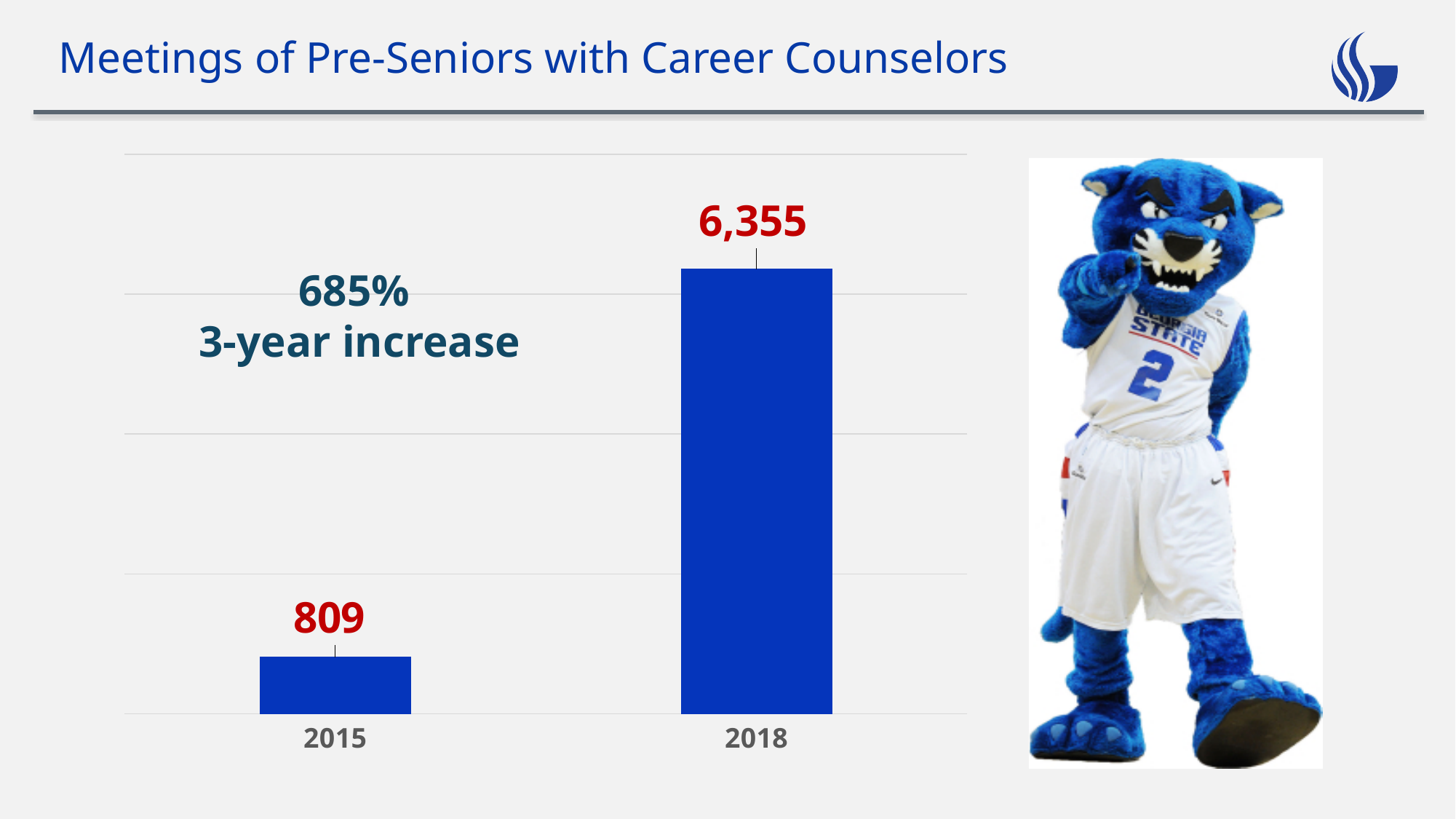
What is the value for 2018? 6,355 Which is larger, the value for 2015 or the value for 2018? 2018 What is the difference between the values for 2018 and 2015? 5,546 Which year has the lowest value? 2015 What is the title of the slide containing the chart? Meetings of Pre-Seniors with Career Counselors What percentage 3-year increase is annotated on the chart? 685% What is the value for 2015? 809 What kind of chart is shown on the slide? bar chart Do the values rise or fall from 2015 to 2018? rise Which year has the highest value? 2018 How many years are shown on the chart? 2